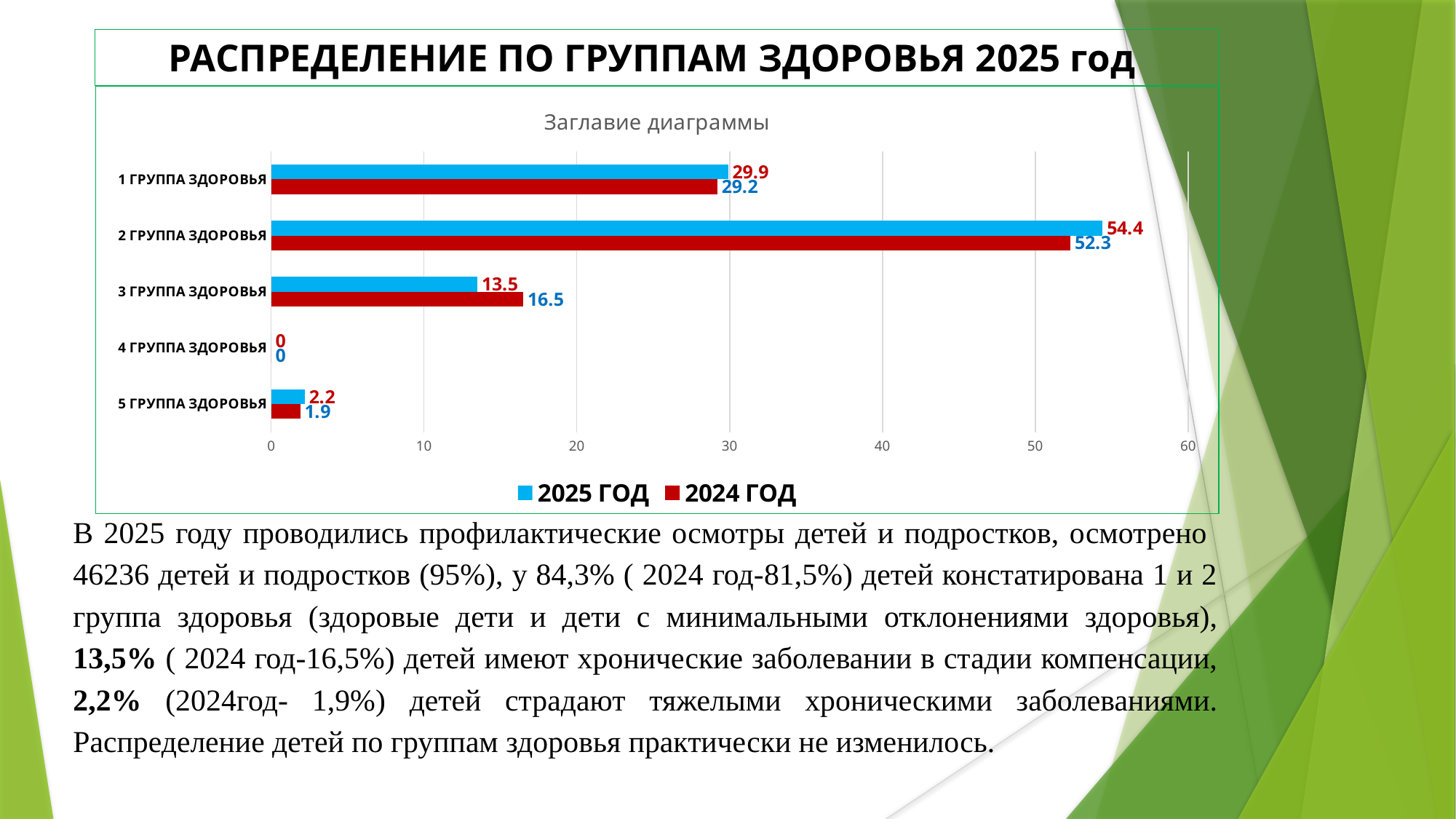
Which health group has the highest value in the 2025 ГОД series? 2 ГРУППА ЗДОРОВЬЯ What is the value for 3 ГРУППА ЗДОРОВЬЯ in the 2024 ГОД series? 16.5 How many series does the legend list? 2 What is the value for 5 ГРУППА ЗДОРОВЬЯ in the 2025 ГОД series? 2.2 What is the difference between the 2024 ГОД and 2025 ГОД values for 3 ГРУППА ЗДОРОВЬЯ? 3 What is the value for 2 ГРУППА ЗДОРОВЬЯ in the 2025 ГОД series? 54.4 For 3 ГРУППА ЗДОРОВЬЯ, which series has the larger value, 2025 ГОД or 2024 ГОД? 2024 ГОД What is the difference between the 2025 ГОД and 2024 ГОД values for 2 ГРУППА ЗДОРОВЬЯ? 2.1 What kind of chart is shown on the slide? Bar chart Which health group has the lowest value in the 2024 ГОД series? 4 ГРУППА ЗДОРОВЬЯ What is the value for 1 ГРУППА ЗДОРОВЬЯ in the 2024 ГОД series? 29.2 How many health group categories are shown on the chart? 5